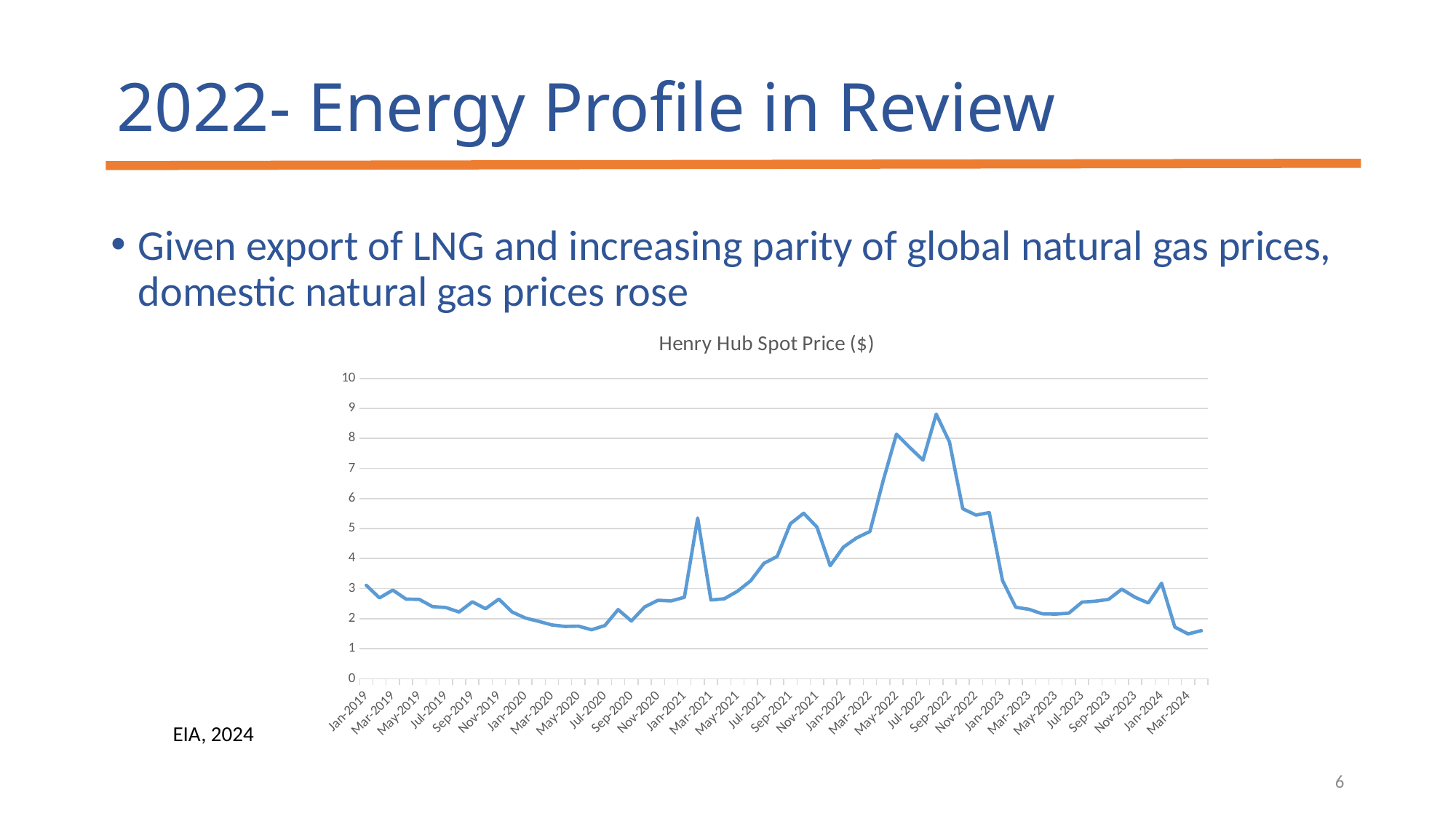
What is the highest value shown on the chart's vertical axis? 10 Is the value for May-2020 greater or less than 2? less Is the value for May-2022 greater or less than 7? greater How many lines are plotted on the chart? 1 In which year does the Henry Hub spot price reach its highest point on the chart? 2022 Which is larger, the value for May-2022 or the value for Mar-2023? May-2022 What is the title of the chart? Henry Hub Spot Price ($) Which is larger, the value for Jan-2019 or the value for Mar-2024? Jan-2019 Does the Henry Hub spot price rise or fall between Sep-2022 and Mar-2023? fall Is the value for Mar-2024 greater or less than 2? less What kind of chart is shown on the slide? line chart